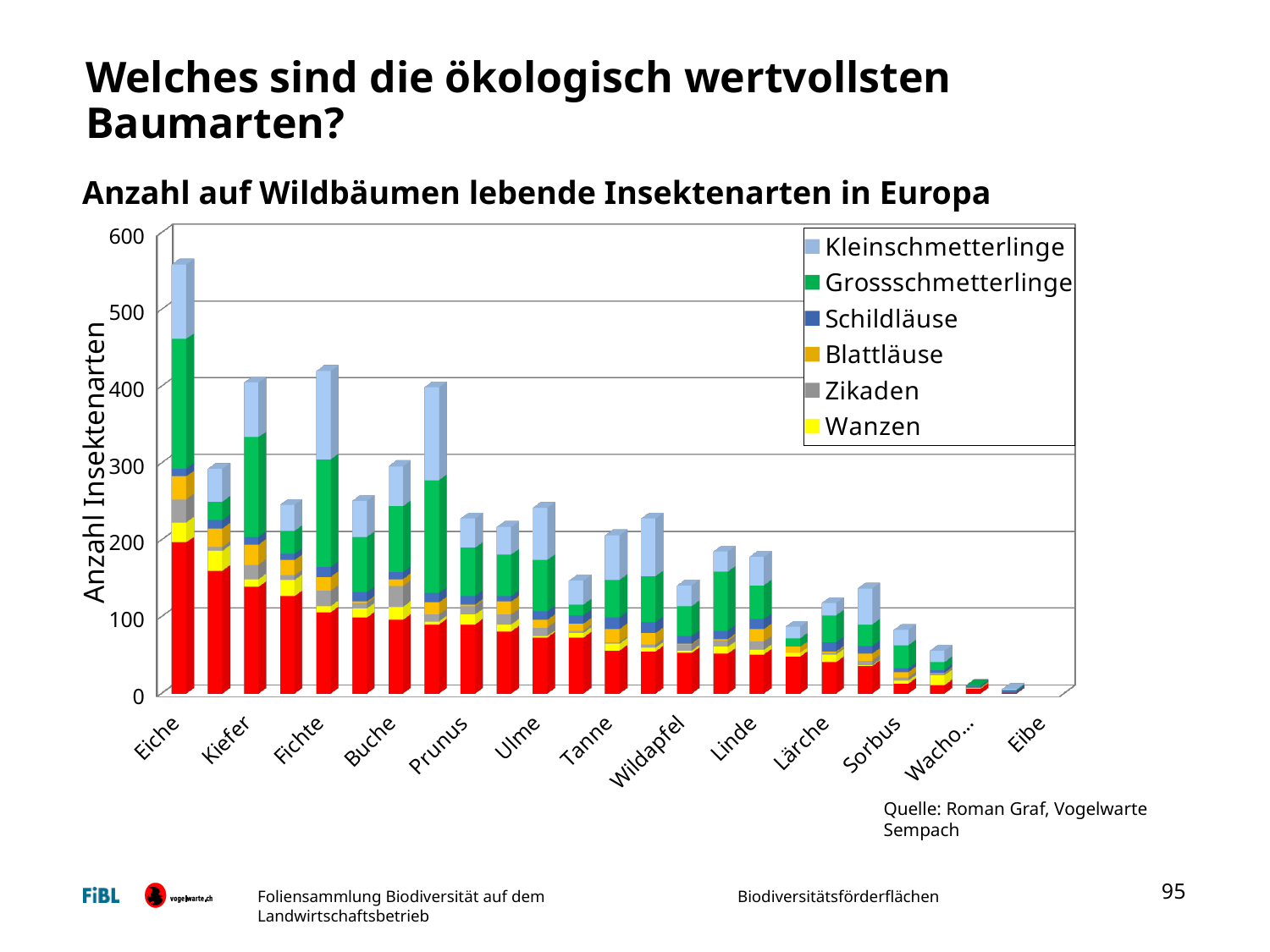
Which labelled tree species has the lowest total number of insect species? Eibe What is the label of the y axis? Anzahl Insektenarten How many series does the legend list? 6 Is the total value for Eibe greater or less than 100? less Is the total value for Kiefer greater or less than 300? greater Which has a higher total number of insect species, Fichte or Buche? Fichte Do the total values generally rise or fall from left to right along the x axis? fall Is the total value for Eiche greater or less than 500? greater What type of chart is shown on the slide? Stacked bar chart Which has a higher total number of insect species, Linde or Eibe? Linde Which tree species has the highest total number of insect species? Eiche